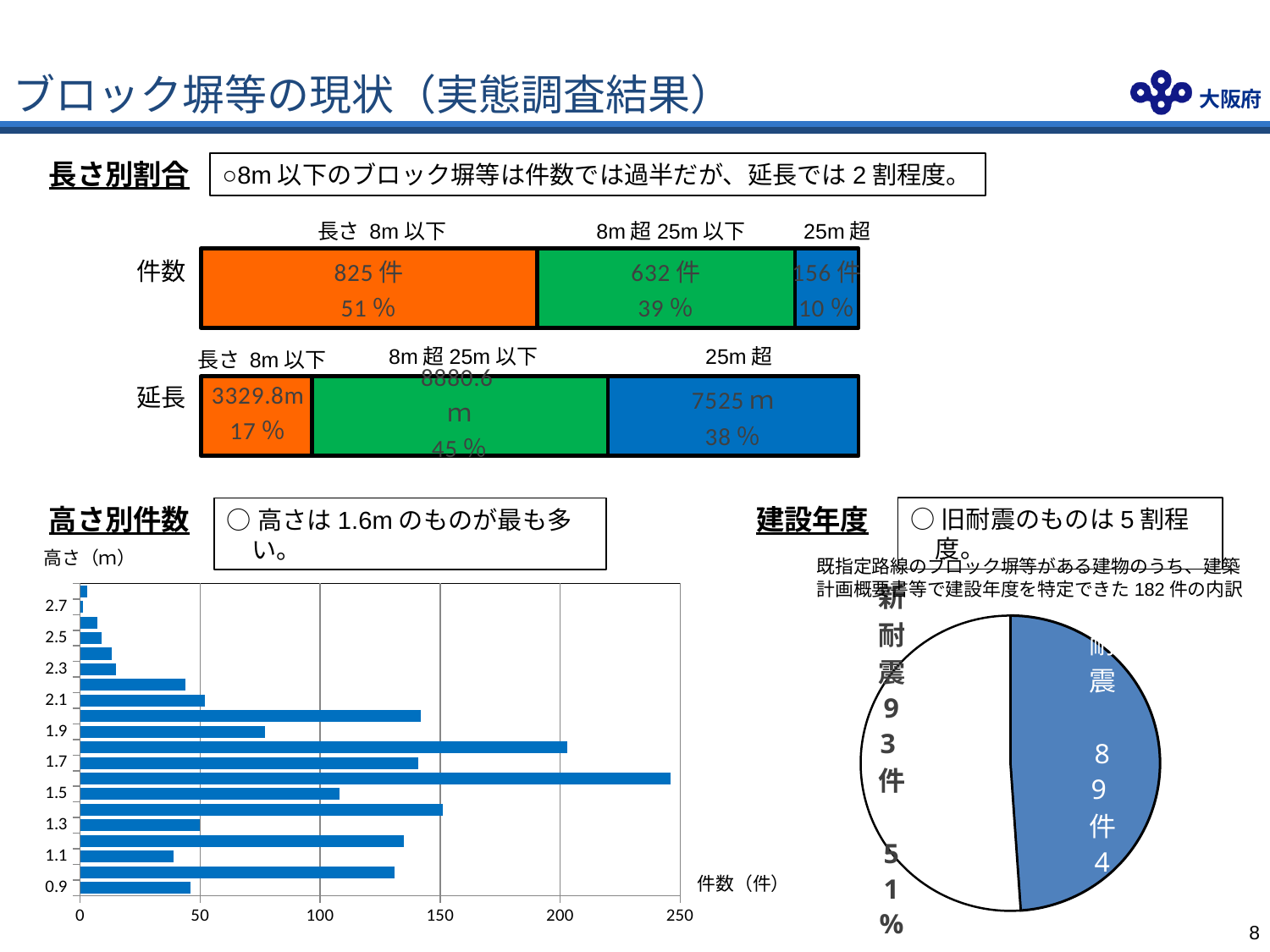
In the 長さ別割合 chart, how many more 件 are in the 8m以下 segment than in the 8m超25m以下 segment of the 件数 bar? 193 件 In the 高さ別件数 chart, which has the larger value, height 1.7 or height 1.1? 1.7 In the 長さ別割合 chart, which length category has the smallest share of the 延長 bar? 長さ 8m以下 In the 長さ別割合 chart, what is the total number of 件 across the three segments of the 件数 bar? 1613 件 In the 高さ別件数 chart, is the value for height 1.5 greater or less than 100? greater In the 高さ別件数 chart, is the value for height 0.9 greater or less than 50? less In the 長さ別割合 chart, what is the length shown for 25m超 in the 延長 bar? 7525 m In the 建設年度 pie chart, how many 件 are 新耐震? 93 件 In the 長さ別割合 chart, how many 件 are in the 長さ 8m以下 segment of the 件数 bar? 825 件 In the 建設年度 pie chart, what share of the pie is 新耐震? 51 % In the 長さ別割合 chart, what percentage of the 件数 bar is 8m超25m以下? 39 % What kind of chart is the 高さ別件数 chart? bar chart